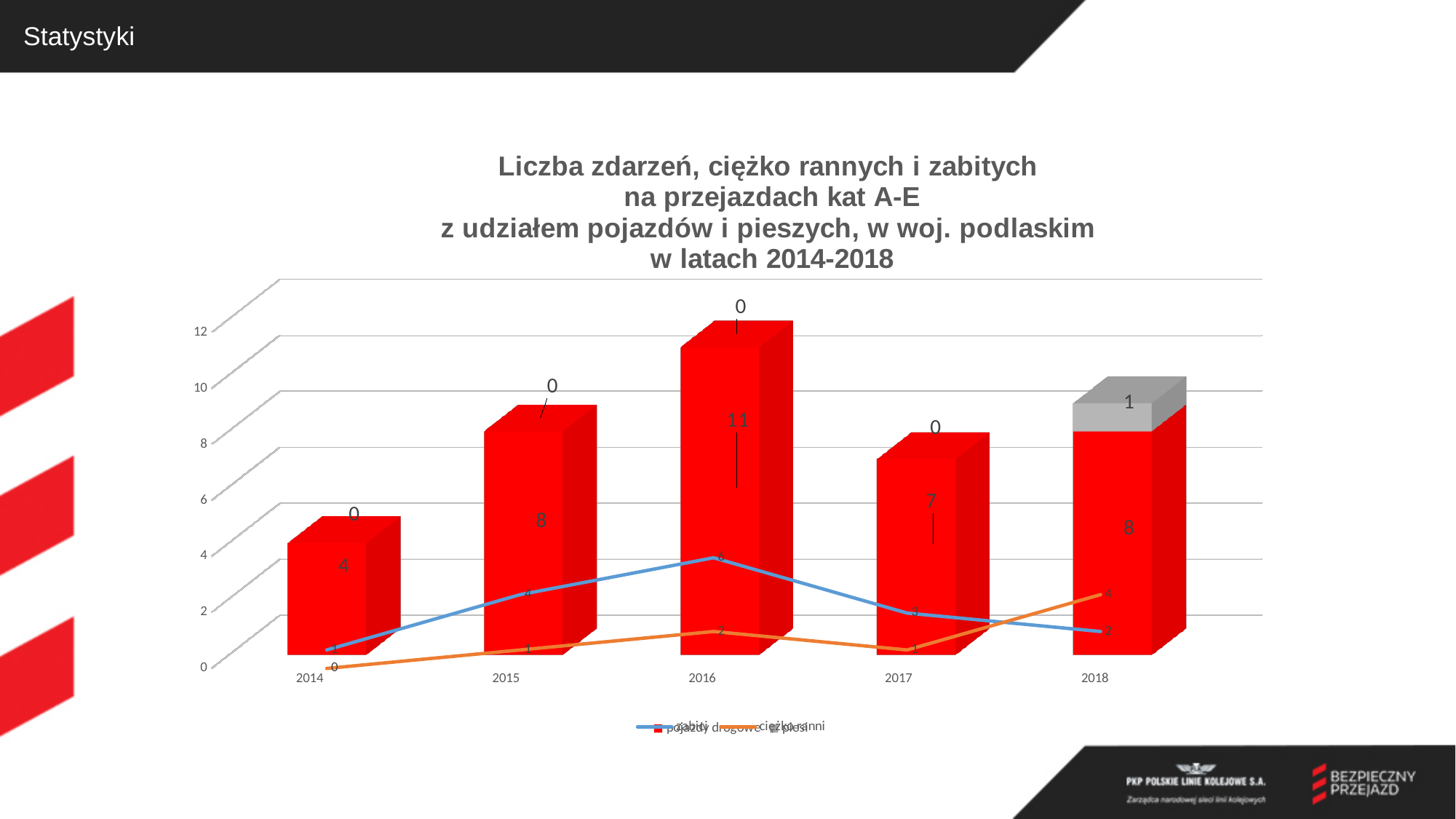
What is the value of the grey segment on top of the 2018 bar? 1 Which year has a larger red bar value, 2015 or 2017? 2015 What kind of chart is shown on the slide? A bar chart with line series overlaid Which year has the shortest red bar? 2014 What is the value of the red bar for 2014? 4 What is the total of the stacked bar for 2018 (red plus grey)? 9 What is the value of the red bar for 2016? 11 What is the difference between the red bar values for 2016 and 2014? 7 What value does the blue line show for 2016? 6 Does the blue line rise or fall from 2016 to 2018? Falls How many years are shown on the x axis? 5 Which year has the tallest red bar? 2016